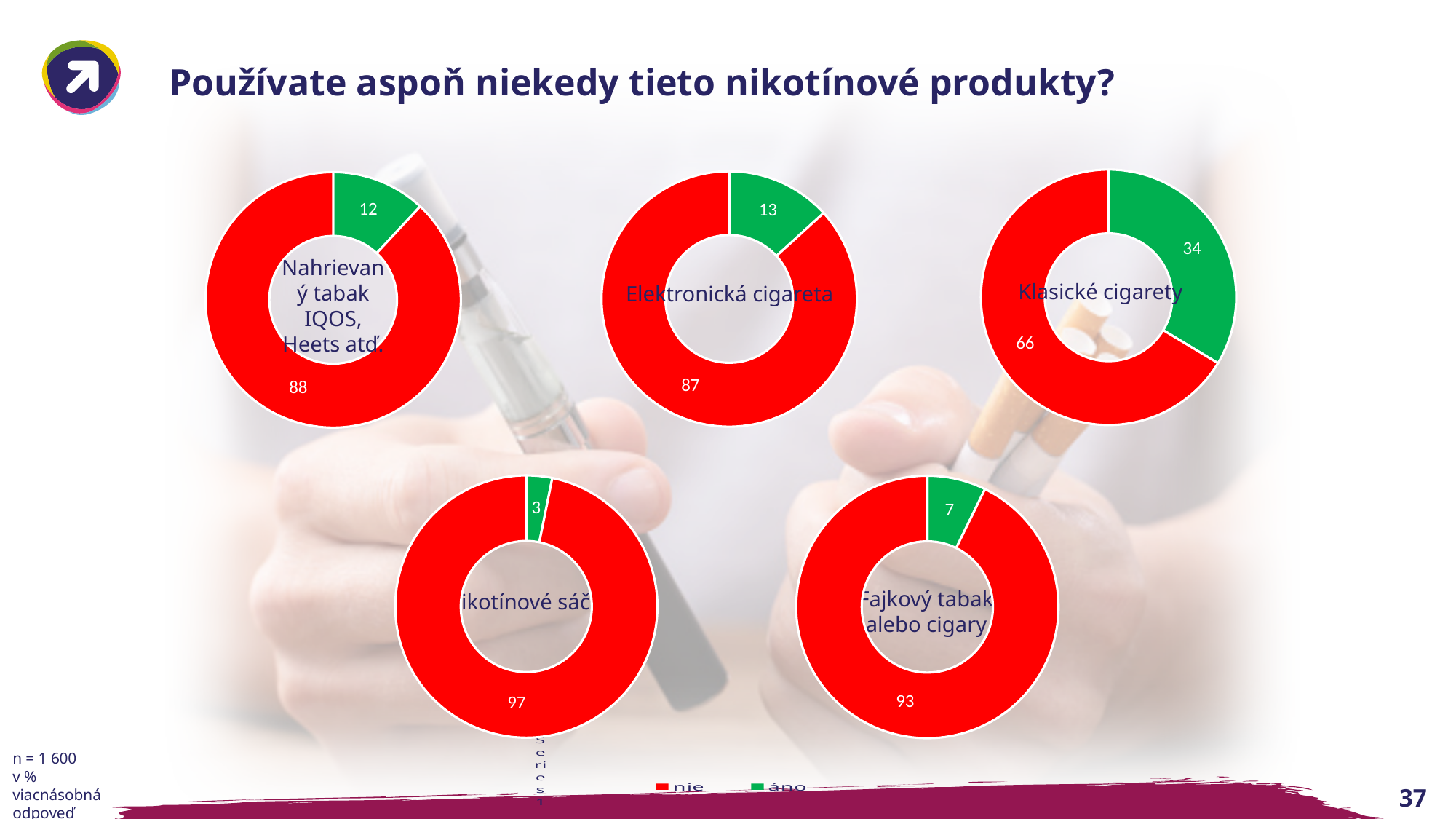
What type of chart is used for 'Nikotínové sáčky'? Donut (pie) chart Which colour represents 'áno' in the donut charts? Green In the 'Klasické cigarety' donut chart, what is the value for 'áno'? 34 In the 'Nikotínové sáčky' donut chart, what is the value for 'áno'? 3 Across the five donut charts on the slide, which product has the lowest 'áno' value? Nikotínové sáčky Which is larger: the 'áno' value in the 'Elektronická cigareta' chart or the 'áno' value in the 'Fajkový tabak alebo cigary' chart? Elektronická cigareta How many series does the legend at the bottom of the slide list? 2 In the 'Elektronická cigareta' donut chart, what is the value for 'nie'? 87 In the 'Fajkový tabak alebo cigary' donut chart, what is the value for 'nie'? 93 Across the five donut charts on the slide, which product has the highest 'áno' value? Klasické cigarety In the 'Nahrievaný tabak IQOS, Heets atď.' donut chart, what is the value for 'áno'? 12 In the 'Klasické cigarety' donut chart, what is the difference between the 'nie' and 'áno' values? 32